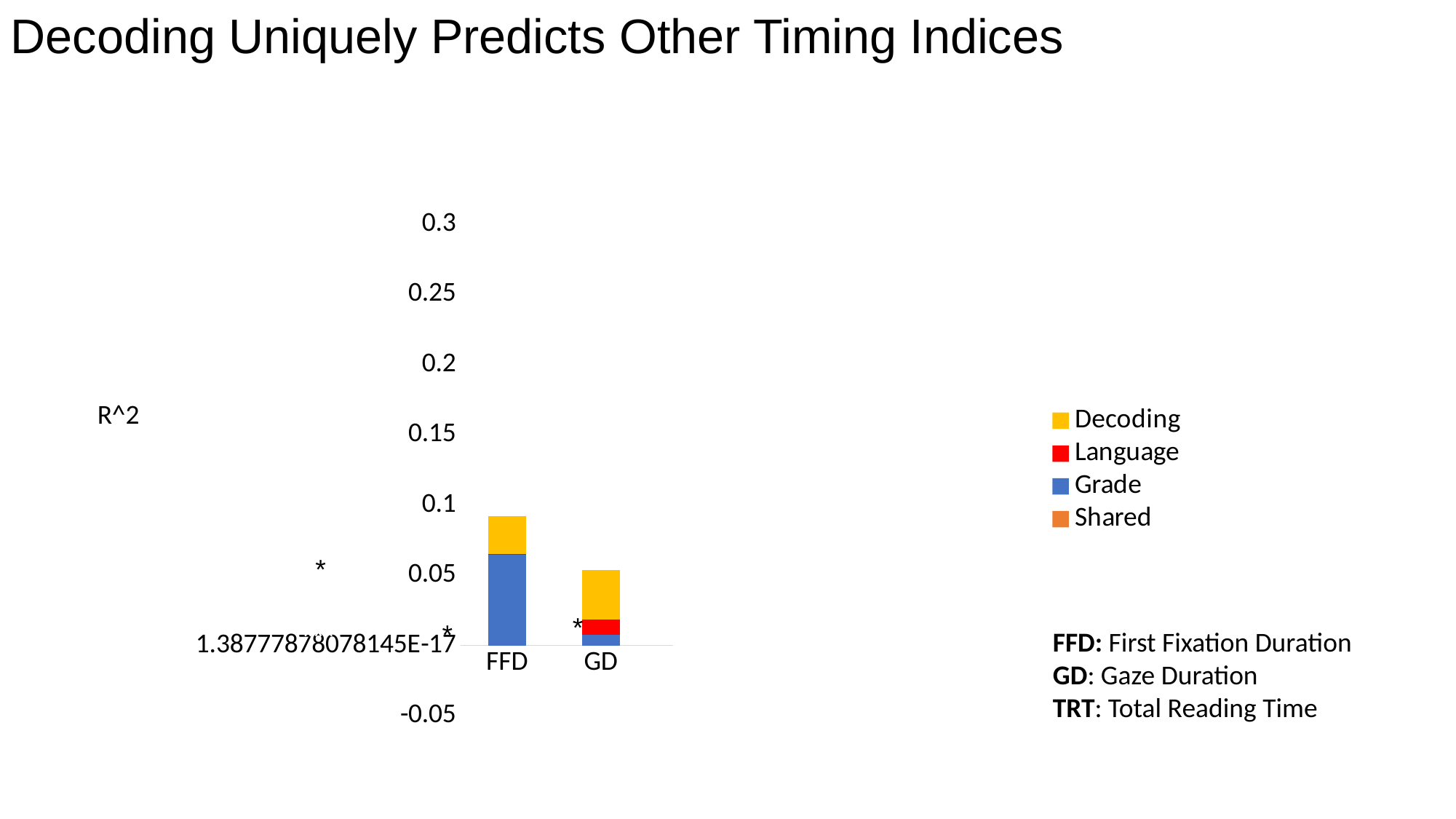
Is the total bar height for FFD greater or less than 0.05? greater Which series is shown in yellow according to the legend? Decoding How many series does the chart's legend list? 4 Is the total bar height for FFD greater or less than 0.1? less What kind of chart is shown on the slide? stacked bar chart Is the Grade segment of the FFD bar greater or less than 0.05? greater Which category has the taller stacked bar, FFD or GD? FFD How many categories are plotted on the x axis of the chart? 2 Which category has the lowest total bar height? GD Which category shows a visible Language (red) segment in its bar? GD What label is shown on the vertical axis of the chart? R^2